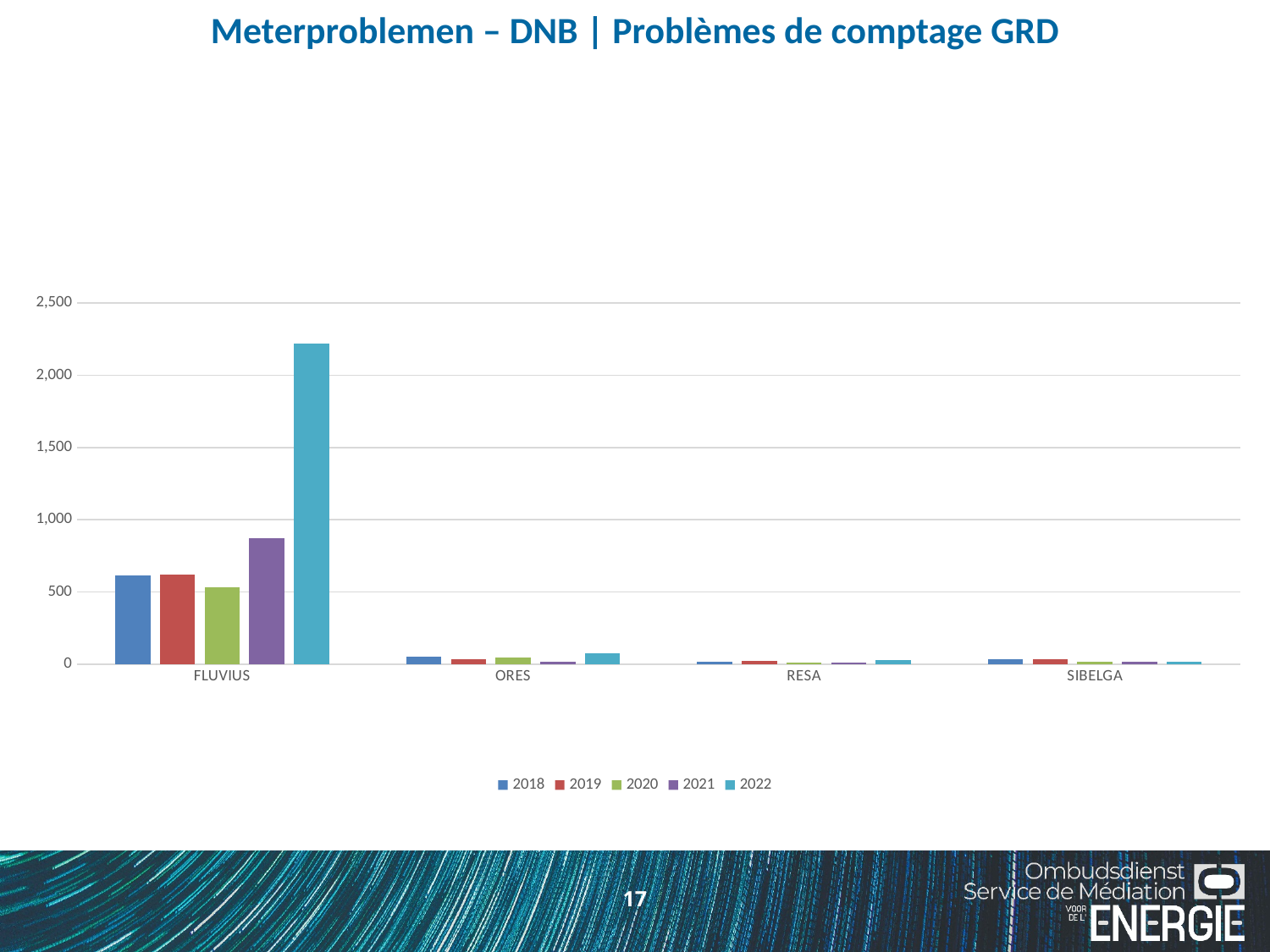
How many categories (network operators) are shown on the x axis? 4 Is the value for FLUVIUS in 2022 greater or less than 2,000? greater Is the value for FLUVIUS in 2018 greater or less than 500? greater What is the title of the chart on the slide? Meterproblemen – DNB | Problèmes de comptage GRD Which is larger for FLUVIUS: the value for 2021 or the value for 2020? 2021 What kind of chart is shown on the slide? bar chart Is the value for ORES in 2022 greater or less than 500? less For FLUVIUS, which year has the highest value? 2022 For FLUVIUS, which year has the lowest value? 2020 Which network operator has the tallest bar in the chart? FLUVIUS How many series does the legend list? 5